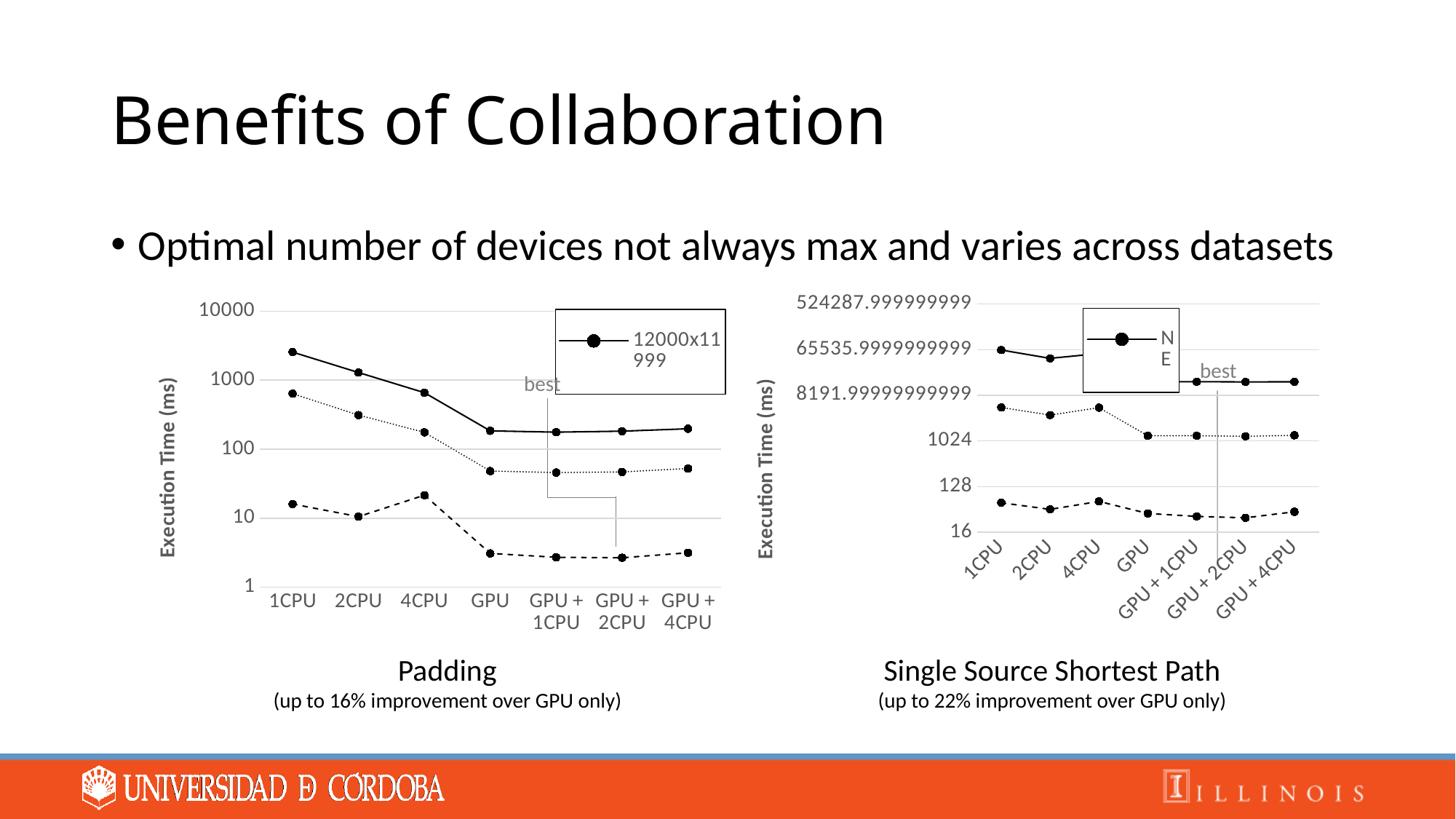
In the Padding chart, does the solid line rise or fall from 1CPU to GPU? fall In the Padding chart, is the value of the dotted line at 1CPU greater or less than 1000? less In the Single Source Shortest Path chart, is the value of the dashed line at 1CPU greater or less than 128? less How many categories are on the x axis of the Single Source Shortest Path chart? 7 In the Padding chart, is the value of the dashed line at GPU greater or less than 10? less What is the y-axis title of the Padding chart? Execution Time (ms) Which x-axis category is marked as "best" in the Single Source Shortest Path chart? GPU + 2CPU How many categories are on the x axis of the Padding chart? 7 What kind of chart is the Padding chart? line chart